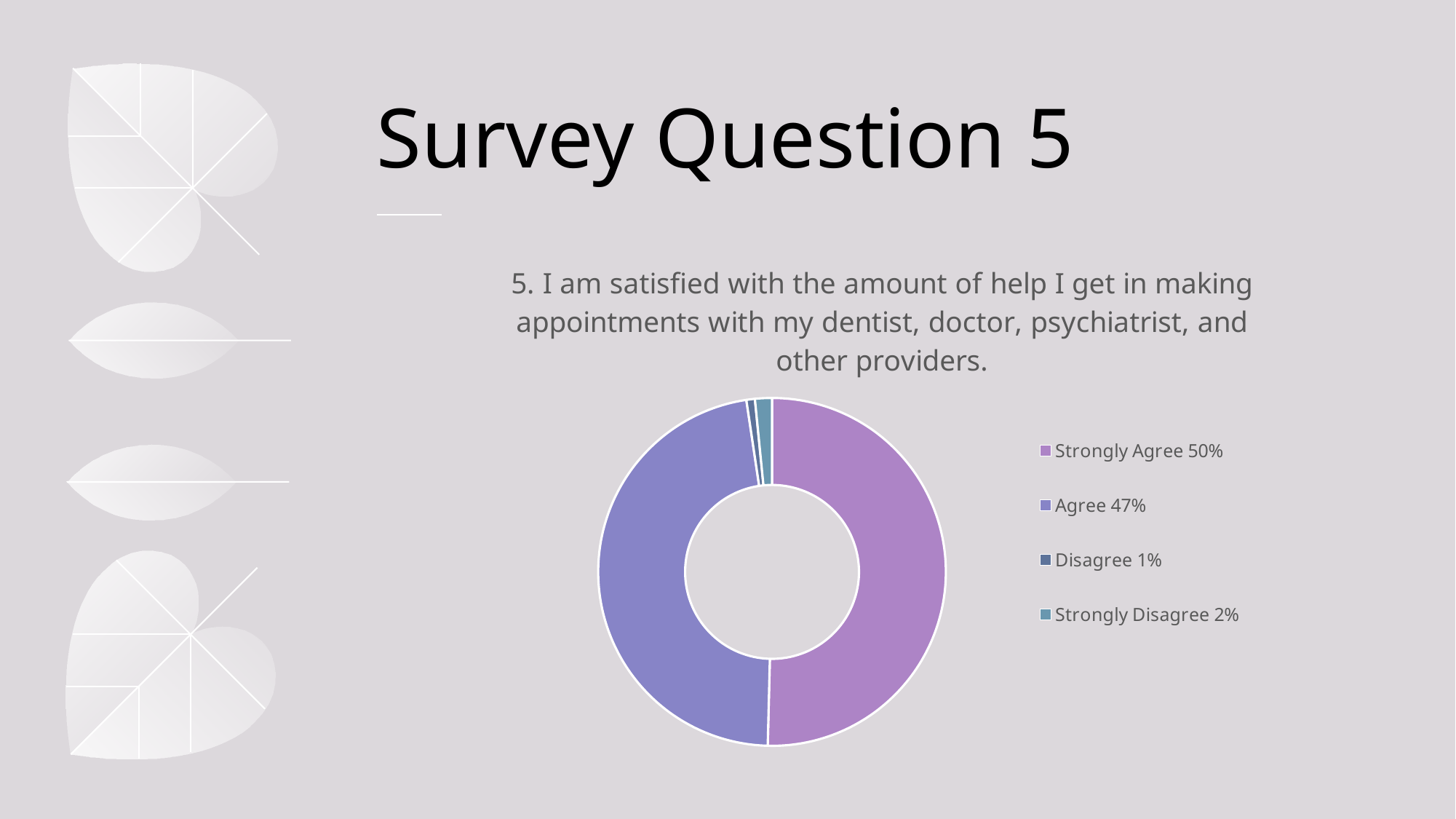
How many response categories does the legend list? 4 Which response category has the largest share? Strongly Agree What percentage of respondents answered Strongly Agree? 50% Which is larger, the share for Strongly Disagree or the share for Disagree? Strongly Disagree What kind of chart is shown on the slide? Doughnut chart What colour represents the Strongly Agree category in the chart? Purple What is the combined share of Strongly Agree and Agree? 97% What percentage of respondents answered Agree? 47% Which response category has the smallest share? Disagree What percentage of respondents answered Strongly Disagree? 2% What percentage of respondents answered Disagree? 1% What is the difference in percentage points between Strongly Agree and Agree? 3